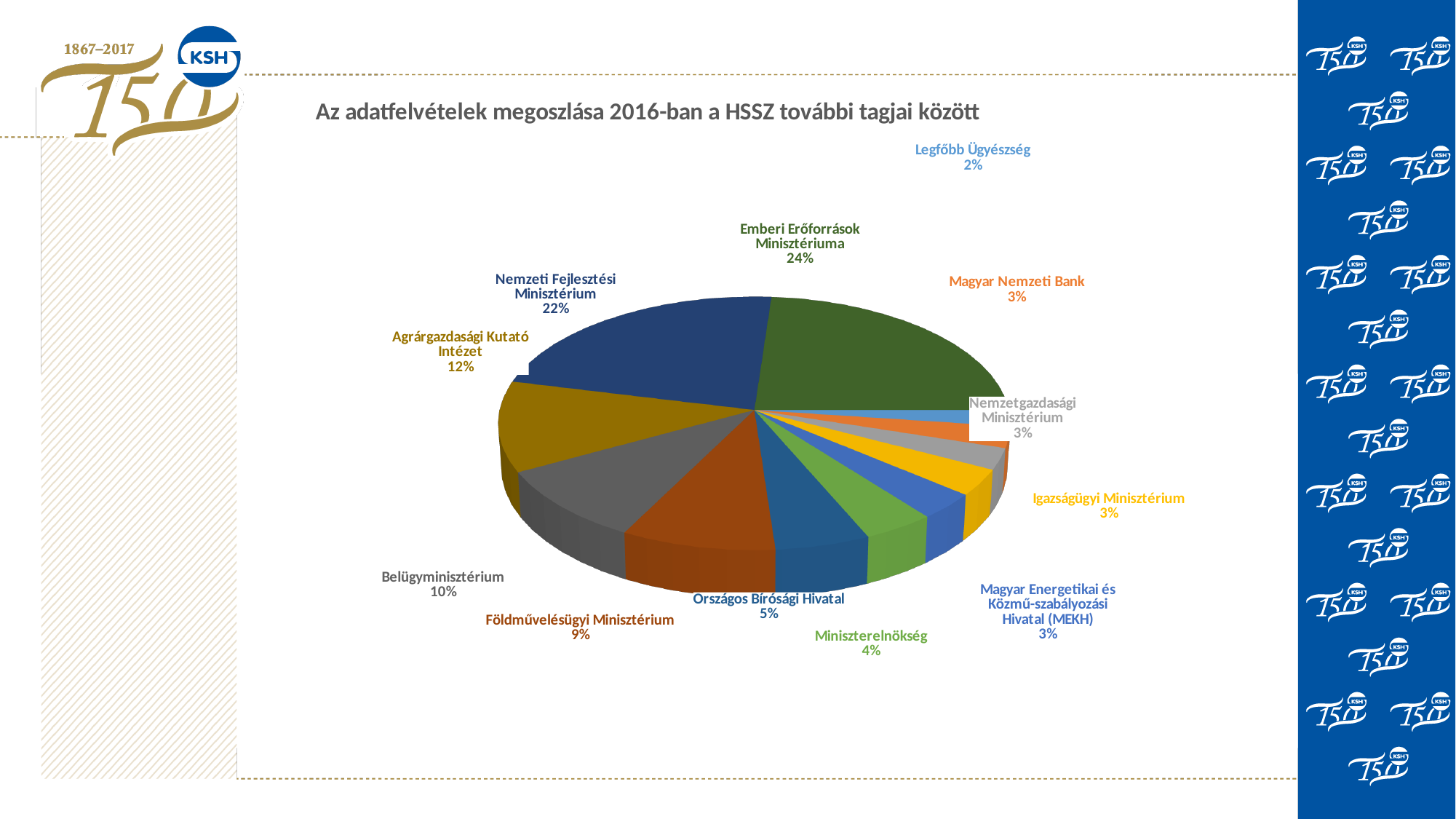
Which has a larger share, Belügyminisztérium or Földművelésügyi Minisztérium? Belügyminisztérium What is the combined share of Belügyminisztérium and Földművelésügyi Minisztérium? 19% What is the difference in percentage points between Emberi Erőforrások Minisztériuma and Nemzeti Fejlesztési Minisztérium? 2 percentage points Which category has the largest share of the pie? Emberi Erőforrások Minisztériuma How many categories (slices) does the pie chart have? 12 What is the title of the chart? Az adatfelvételek megoszlása 2016-ban a HSSZ további tagjai között What share of the pie does Emberi Erőforrások Minisztériuma have? 24% What percentage is shown for Nemzeti Fejlesztési Minisztérium? 22% What type of chart is shown on the slide? pie chart Which category has the smallest share of the pie? Legfőbb Ügyészség What percentage is shown for Agrárgazdasági Kutató Intézet? 12% What is the value for Országos Bírósági Hivatal? 5%